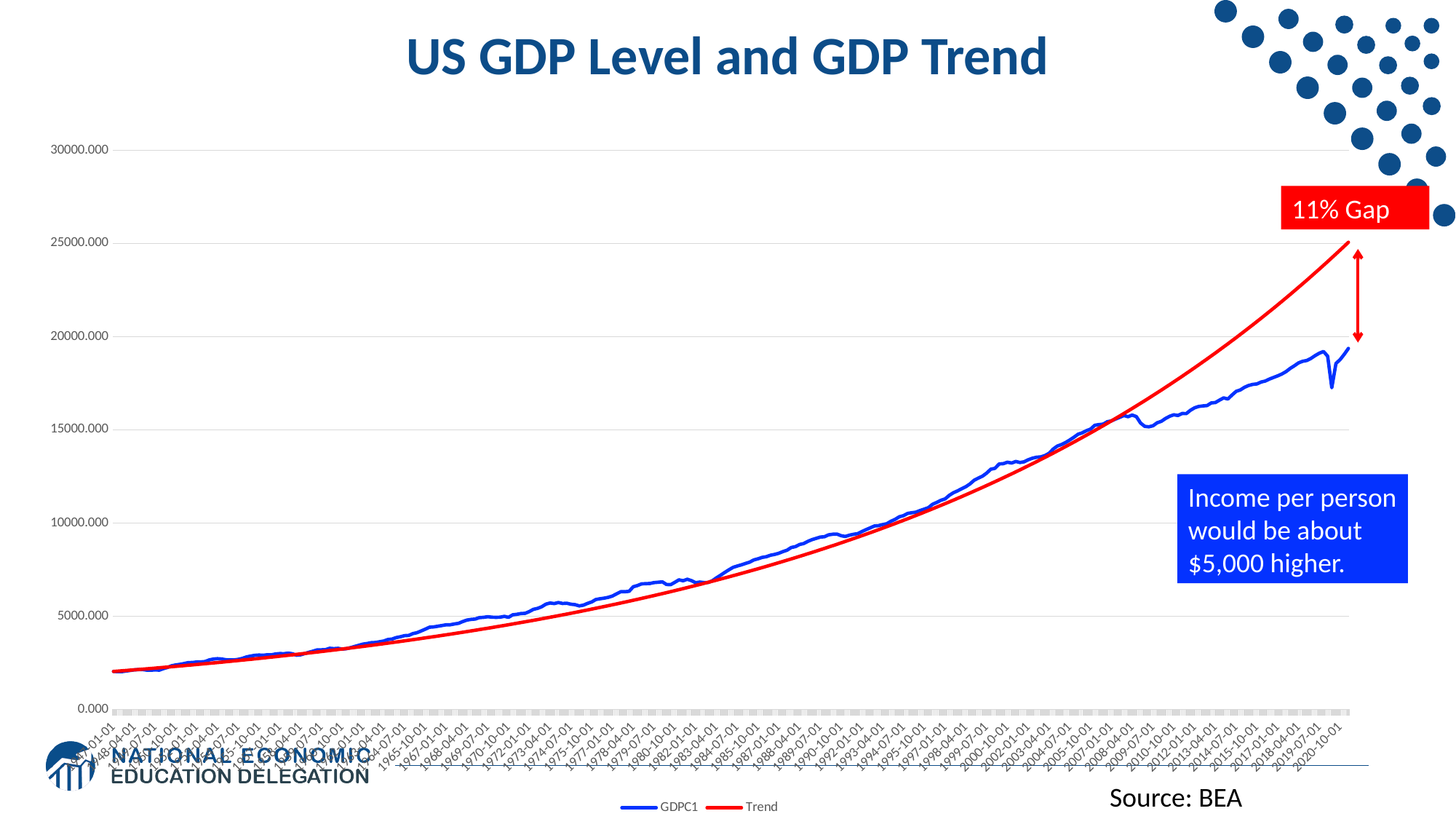
What kind of chart is shown on the slide? line chart How many series does the legend list? 2 Is the value of the GDPC1 series at the right end of the chart greater or less than 20000.000? less Do the values of the Trend series rise or fall along the x axis? rise What are the two series named in the legend? GDPC1 and Trend Is the value of the GDPC1 series at the left end of the chart (1948) greater or less than 5000.000? less What percentage gap between the two series is labelled on the chart? 11% Gap Which colour is used for the Trend series line? red What is the title of the chart? US GDP Level and GDP Trend At the right end of the chart (2020), which series is higher, GDPC1 or Trend? Trend Overall, do the GDPC1 values rise or fall from the start to the end of the x axis? rise Is the value of the Trend series at the right end of the chart greater or less than 20000.000? greater